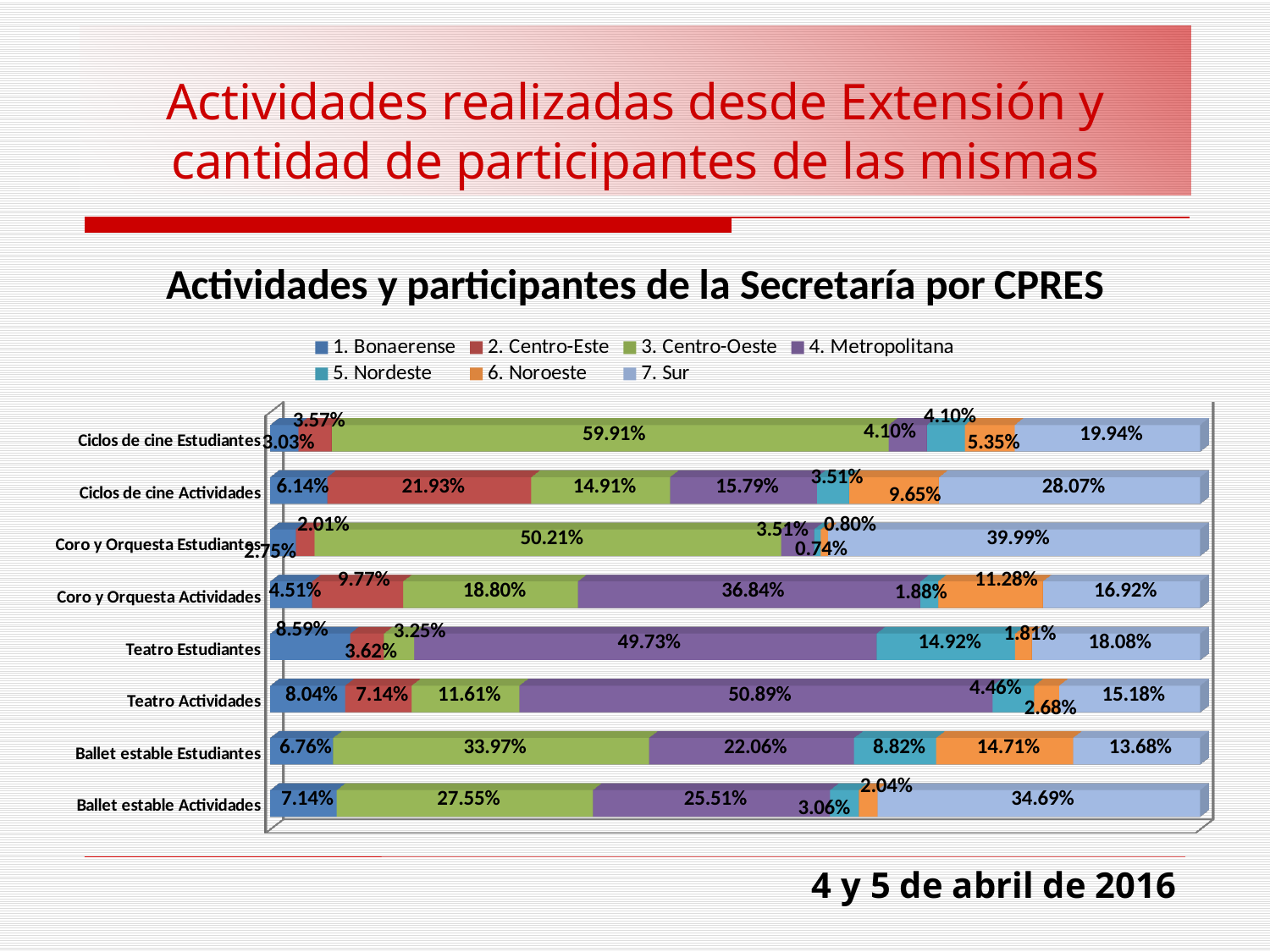
What is the value for 4. Metropolitana in the Teatro Actividades bar? 50.89% Which is larger: the 2. Centro-Este value for Ciclos de cine Actividades or for Coro y Orquesta Actividades? Ciclos de cine Actividades What is the value for 6. Noroeste in the Ballet estable Estudiantes bar? 14.71% Which series has the largest share in the Coro y Orquesta Actividades bar? 4. Metropolitana What is the value for 7. Sur in the Coro y Orquesta Estudiantes bar? 39.99% Which series has the smallest share in the Teatro Estudiantes bar? 6. Noroeste What is the value for 3. Centro-Oeste in the Ciclos de cine Estudiantes bar? 59.91% What kind of chart is shown on the slide? Stacked bar chart What is the difference between the 7. Sur values for Ballet estable Actividades and Ballet estable Estudiantes? 21.01% How many categories are plotted on the chart? 8 What is the title of the chart? Actividades y participantes de la Secretaría por CPRES How many series does the legend list? 7